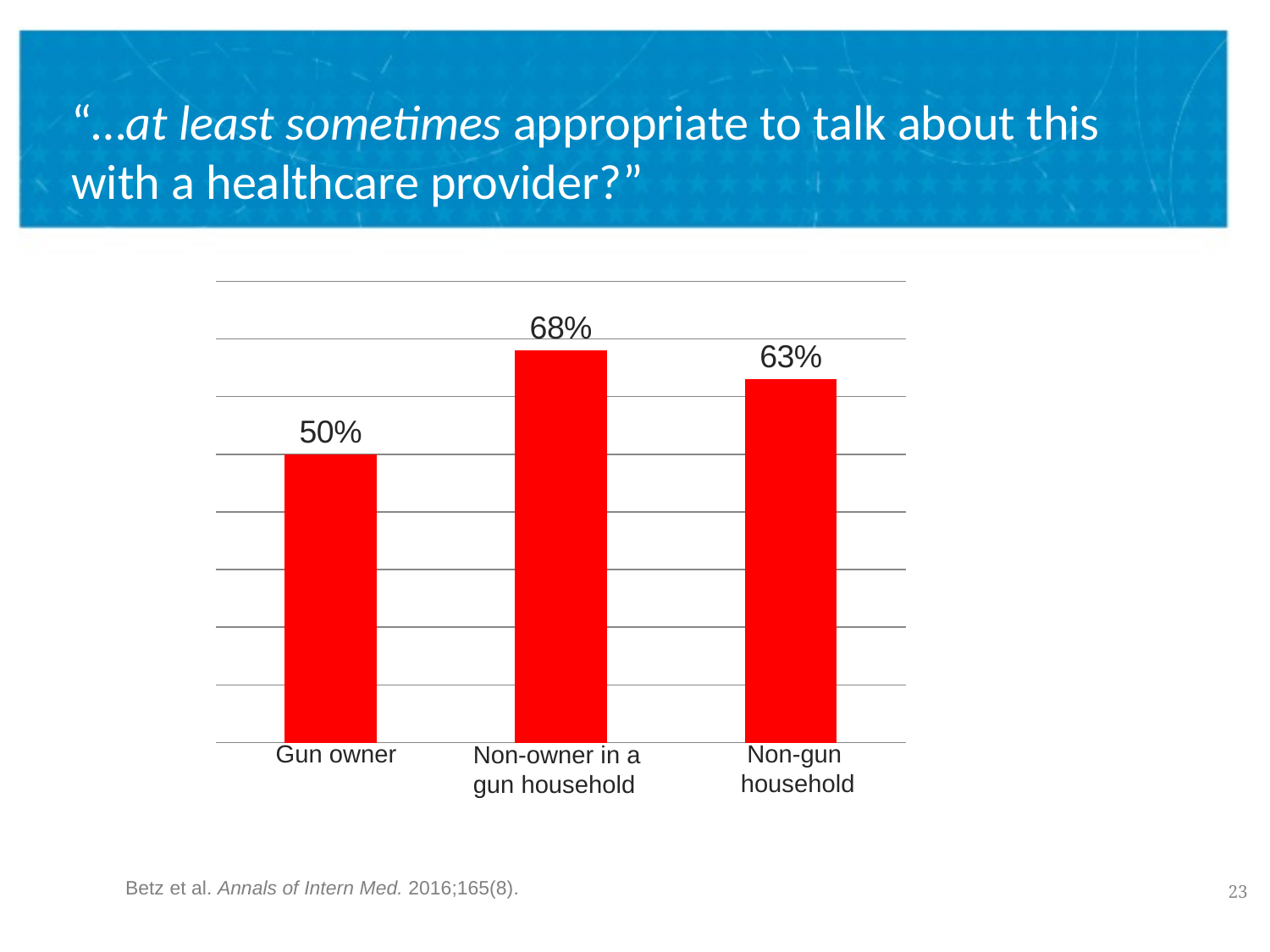
Which category has the highest value? Non-owner in a gun household What colour are the bars in the chart? Red How many categories are shown in the chart? 3 What kind of chart is shown on the slide? Bar chart What is the value for Non-owner in a gun household? 68% Which category has the lowest value? Gun owner What is the value for Non-gun household? 63% What is the value for Gun owner? 50% What is the difference between the values for Non-owner in a gun household and Gun owner? 18% Which is larger, the value for Non-gun household or the value for Gun owner? Non-gun household What is the difference between the values for Non-gun household and Gun owner? 13% Which is larger, the value for Non-owner in a gun household or the value for Non-gun household? Non-owner in a gun household